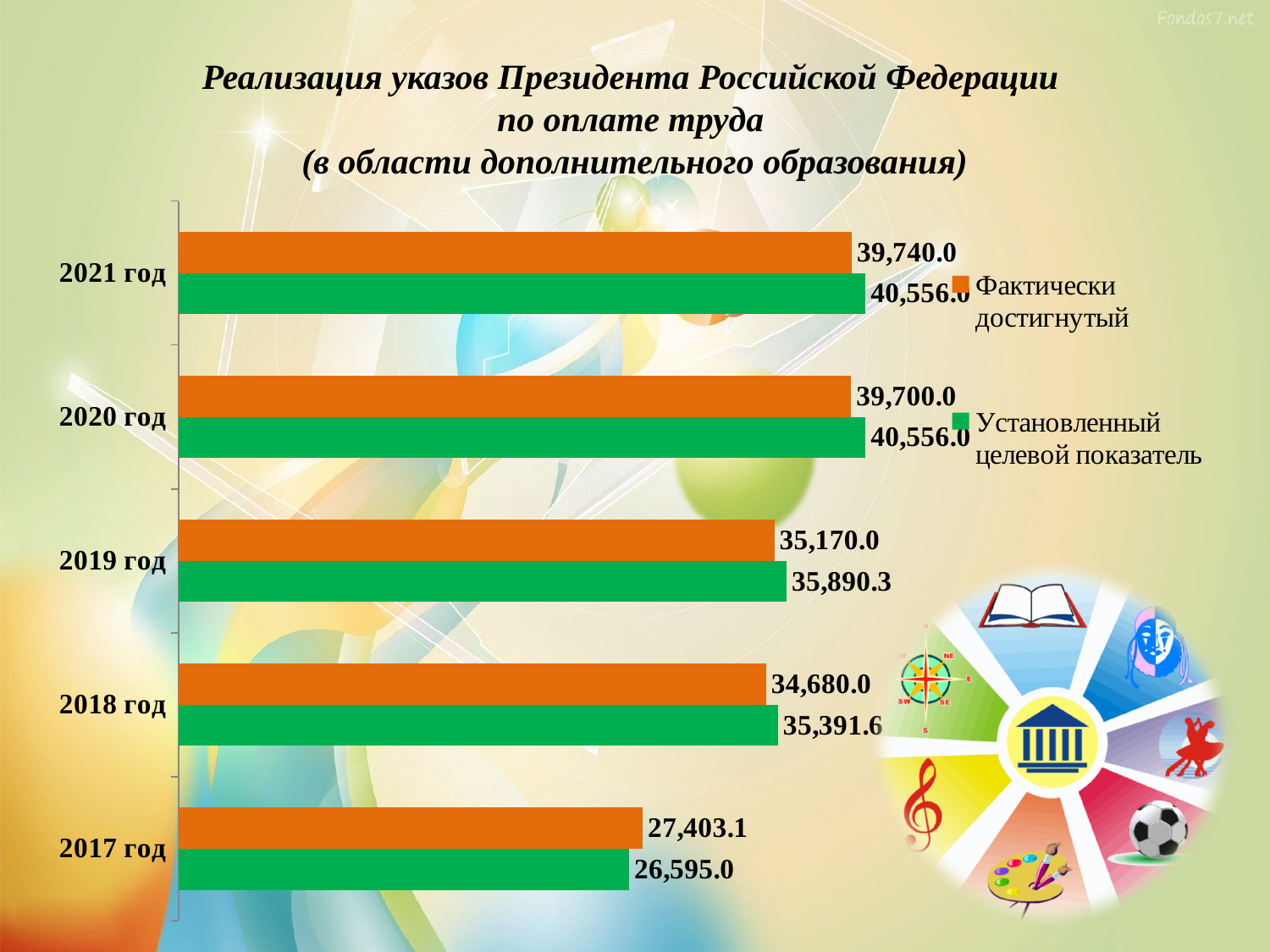
What is the value of «Установленный целевой показатель» for 2019 год? 35,890.3 For 2017 год, which is larger: «Фактически достигнутый» or «Установленный целевой показатель»? Фактически достигнутый Which year has the lowest value of «Фактически достигнутый»? 2017 год What is the value of «Фактически достигнутый» for 2021 год? 39,740.0 What is the value of «Установленный целевой показатель» for 2018 год? 35,391.6 What is the value of «Фактически достигнутый» for 2017 год? 27,403.1 Which year has the highest value of «Фактически достигнутый»? 2021 год What is the difference between «Установленный целевой показатель» and «Фактически достигнутый» for 2021 год? 816.0 How many series does the legend list? 2 How many years are shown on the chart? 5 What kind of chart is shown on the slide? Bar chart What is the difference between «Фактически достигнутый» and «Установленный целевой показатель» for 2017 год? 808.1